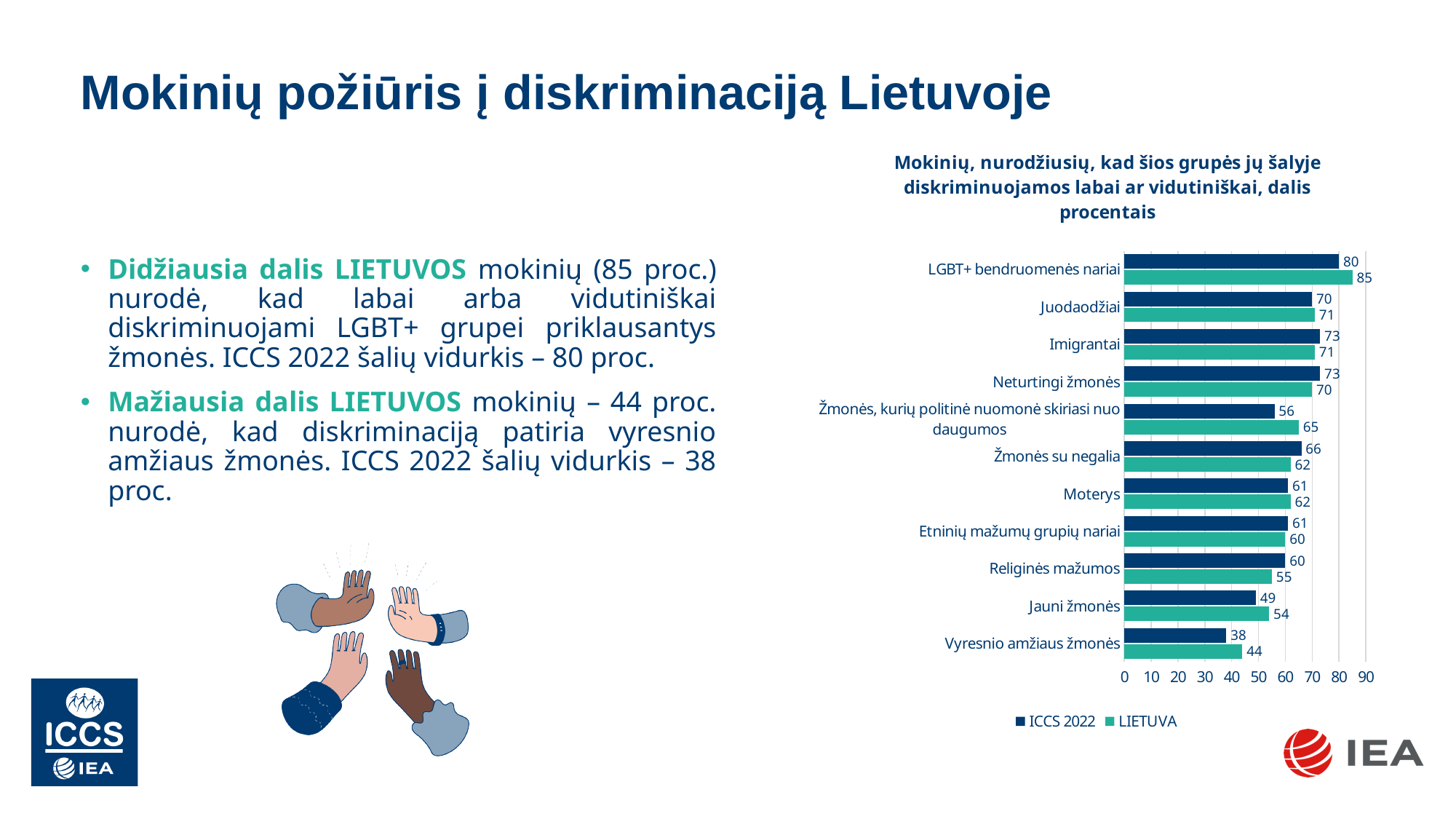
What is the LIETUVA value for LGBT+ bendruomenės nariai? 85 What is the ICCS 2022 value for Vyresnio amžiaus žmonės? 38 How many series does the legend list? 2 What are the two series listed in the chart legend? ICCS 2022 and LIETUVA How many categories are shown on the chart? 11 What is the difference between the LIETUVA and ICCS 2022 values for Žmonės, kurių politinė nuomonė skiriasi nuo daugumos? 9 Which is larger for Jauni žmonės, the ICCS 2022 value or the LIETUVA value? LIETUVA Which category has the lowest ICCS 2022 value? Vyresnio amžiaus žmonės Which is larger for Religinės mažumos, the ICCS 2022 value or the LIETUVA value? ICCS 2022 What is the LIETUVA value for Žmonės, kurių politinė nuomonė skiriasi nuo daugumos? 65 Which category has the highest LIETUVA value? LGBT+ bendruomenės nariai What kind of chart is shown on the slide? Bar chart